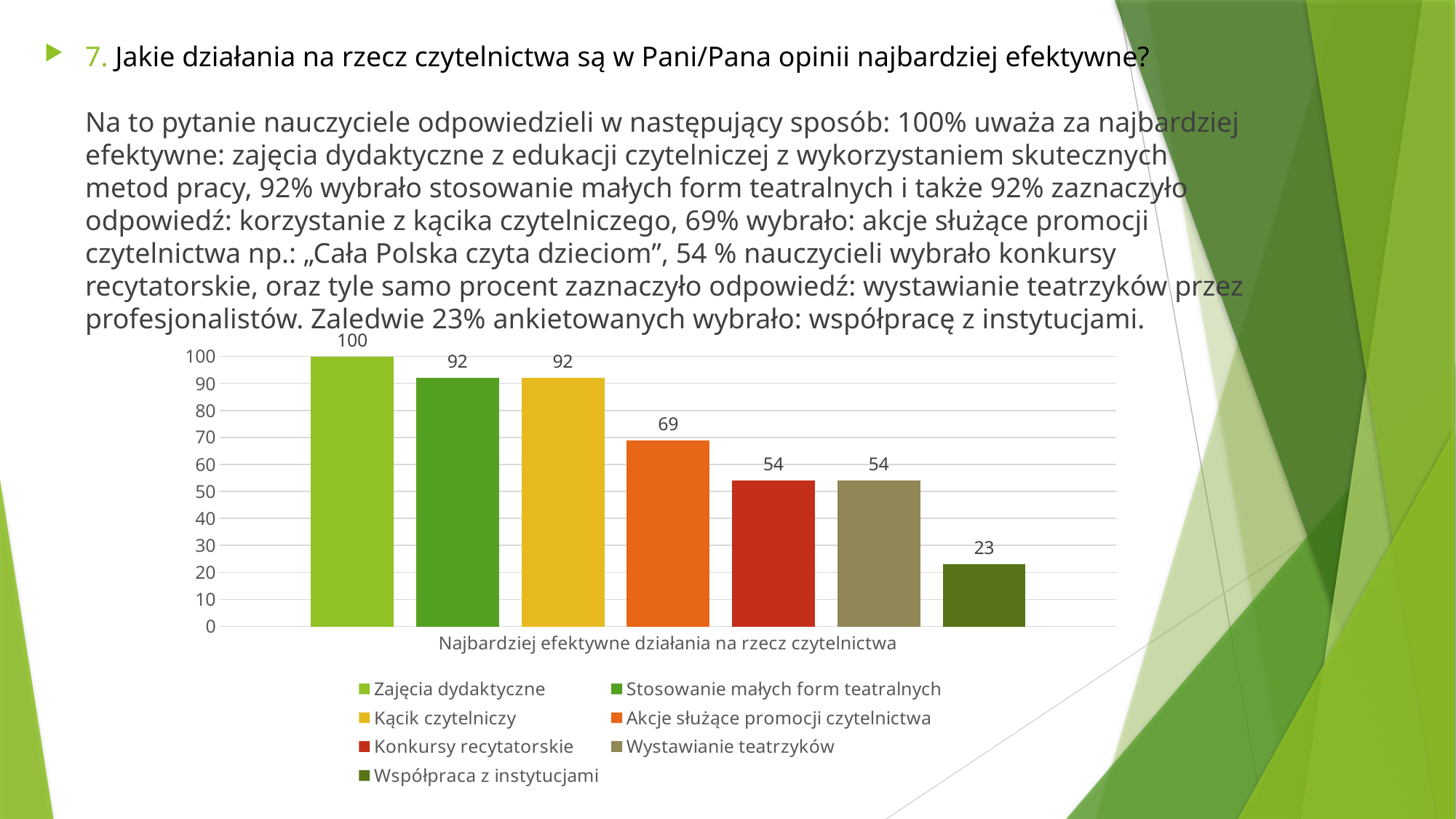
What is the difference between the values for Stosowanie małych form teatralnych and Akcje służące promocji czytelnictwa? 23 What kind of chart is shown on the slide? bar chart Which is larger, the value for Konkursy recytatorskie or the value for Akcje służące promocji czytelnictwa? Akcje służące promocji czytelnictwa How many series does the legend list? 7 What is the value for Akcje służące promocji czytelnictwa? 69 What is the value for Współpraca z instytucjami? 23 What is the value for Zajęcia dydaktyczne? 100 Which series has the highest value? Zajęcia dydaktyczne What is the value for Kącik czytelniczy? 92 What is the category label shown under the bars on the x axis? Najbardziej efektywne działania na rzecz czytelnictwa Which series has the lowest value? Współpraca z instytucjami What is the difference between the values for Zajęcia dydaktyczne and Współpraca z instytucjami? 77